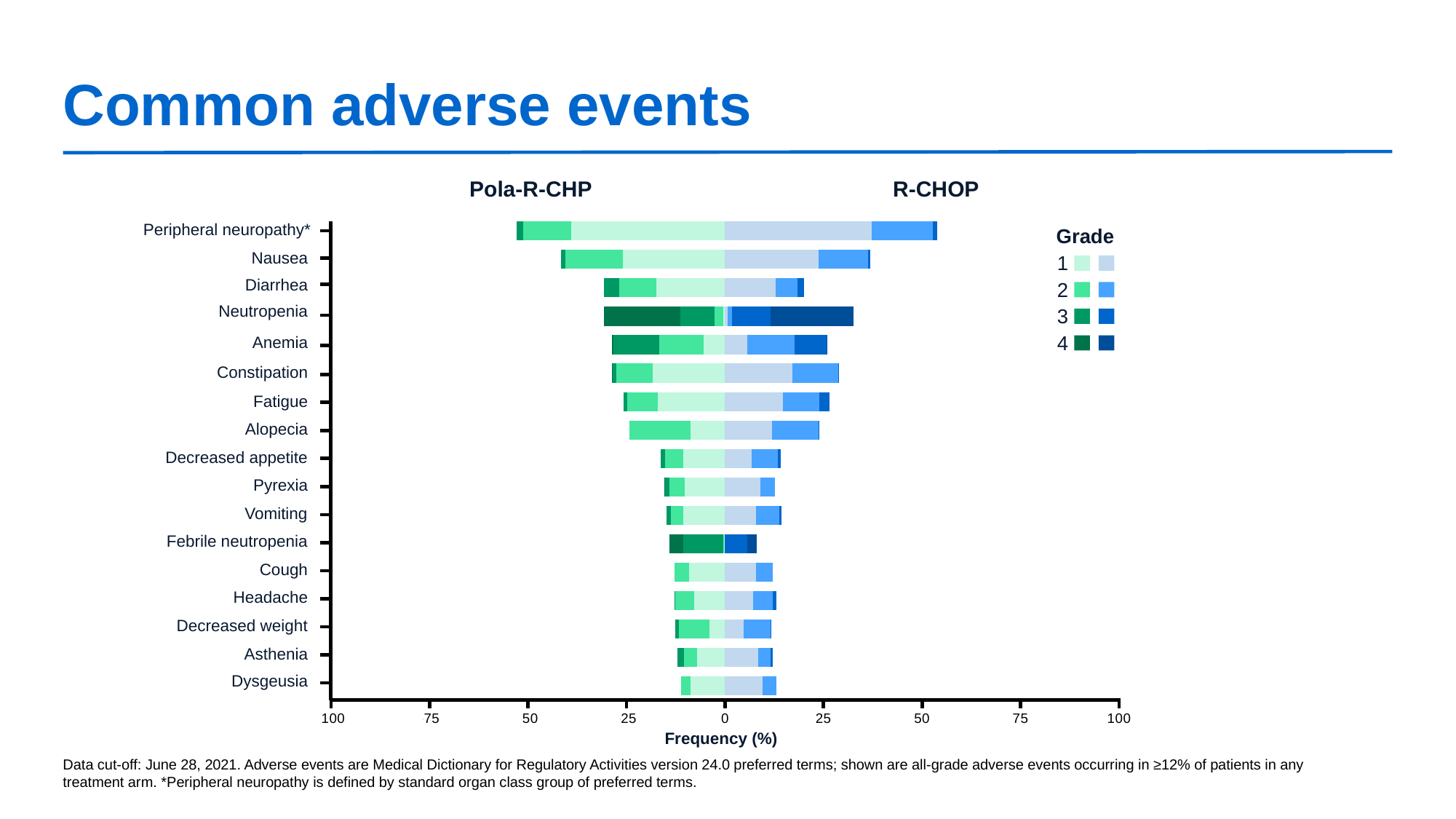
How many adverse events are listed on the y axis of the chart? 17 Is the all-grade frequency of peripheral neuropathy in the Pola-R-CHP arm greater or less than 50? greater In the R-CHOP arm, which has the higher all-grade frequency, alopecia or decreased appetite? Alopecia Which treatment arm is plotted on the left side of the chart? Pola-R-CHP Is the all-grade frequency of neutropenia in the R-CHOP arm greater or less than 25? greater What is the label of the x axis? Frequency (%) Is the all-grade frequency of nausea in the Pola-R-CHP arm greater or less than 50? less What kind of chart is shown on the slide? bar chart Which adverse event has the highest all-grade frequency in the R-CHOP arm? Peripheral neuropathy* In the Pola-R-CHP arm, which has the higher all-grade frequency, nausea or diarrhea? Nausea Which adverse event has the highest all-grade frequency in the Pola-R-CHP arm? Peripheral neuropathy* How many grades does the chart legend list? 4